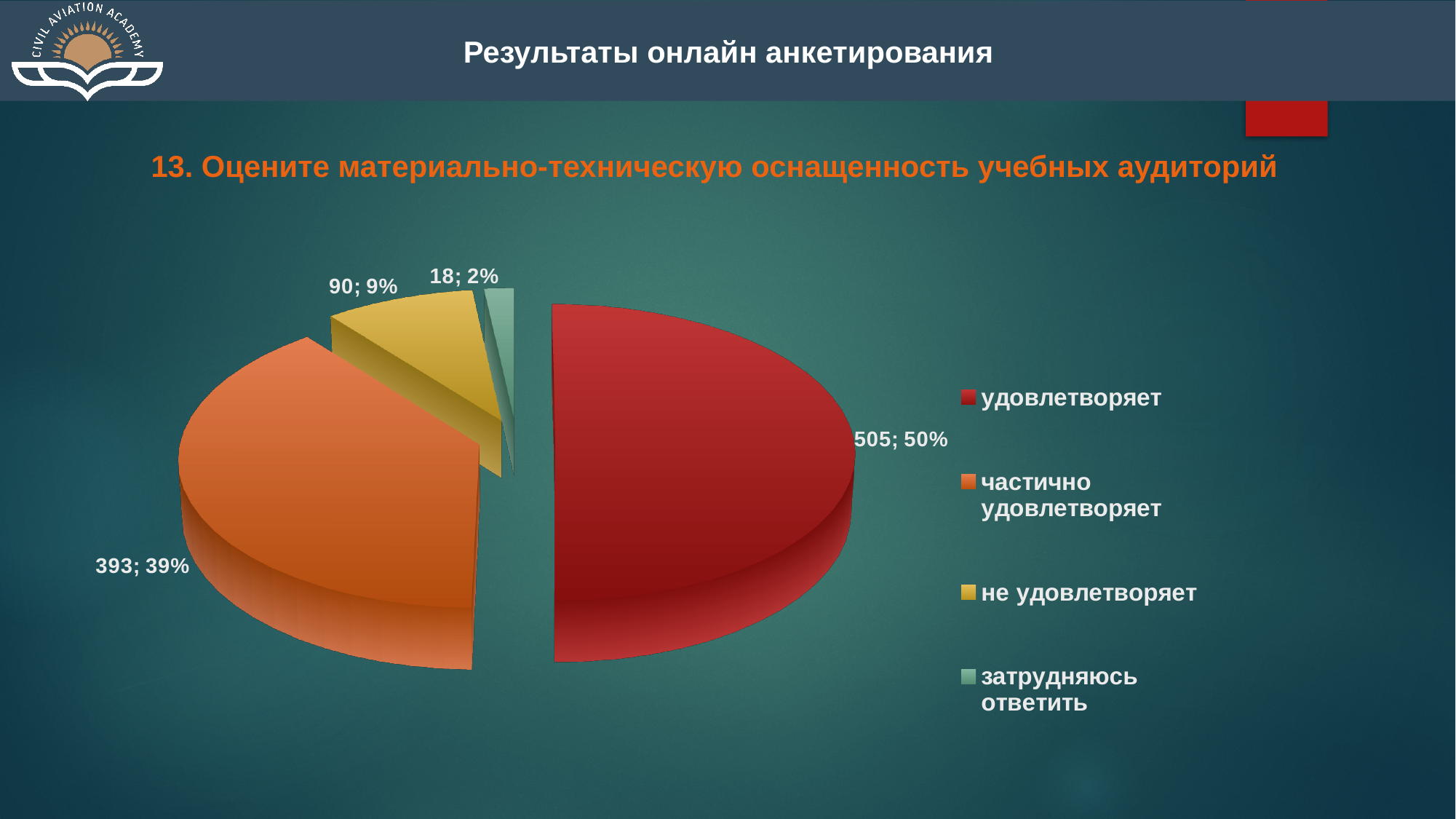
What is the difference between the counts for 'удовлетворяет' and 'частично удовлетворяет'? 112 How many slices does the pie chart have? 4 Which category has the smallest slice? затрудняюсь ответить What is the count for 'не удовлетворяет'? 90 What is the count for 'затрудняюсь ответить'? 18 Which is larger, the count for 'не удовлетворяет' or for 'затрудняюсь ответить'? не удовлетворяет How many entries does the legend list? 4 What share of the pie does 'частично удовлетворяет' represent? 39% Which category has the largest slice? удовлетворяет What kind of chart is shown on the slide? pie chart What is the count for 'удовлетворяет'? 505 What is the count for 'частично удовлетворяет'? 393